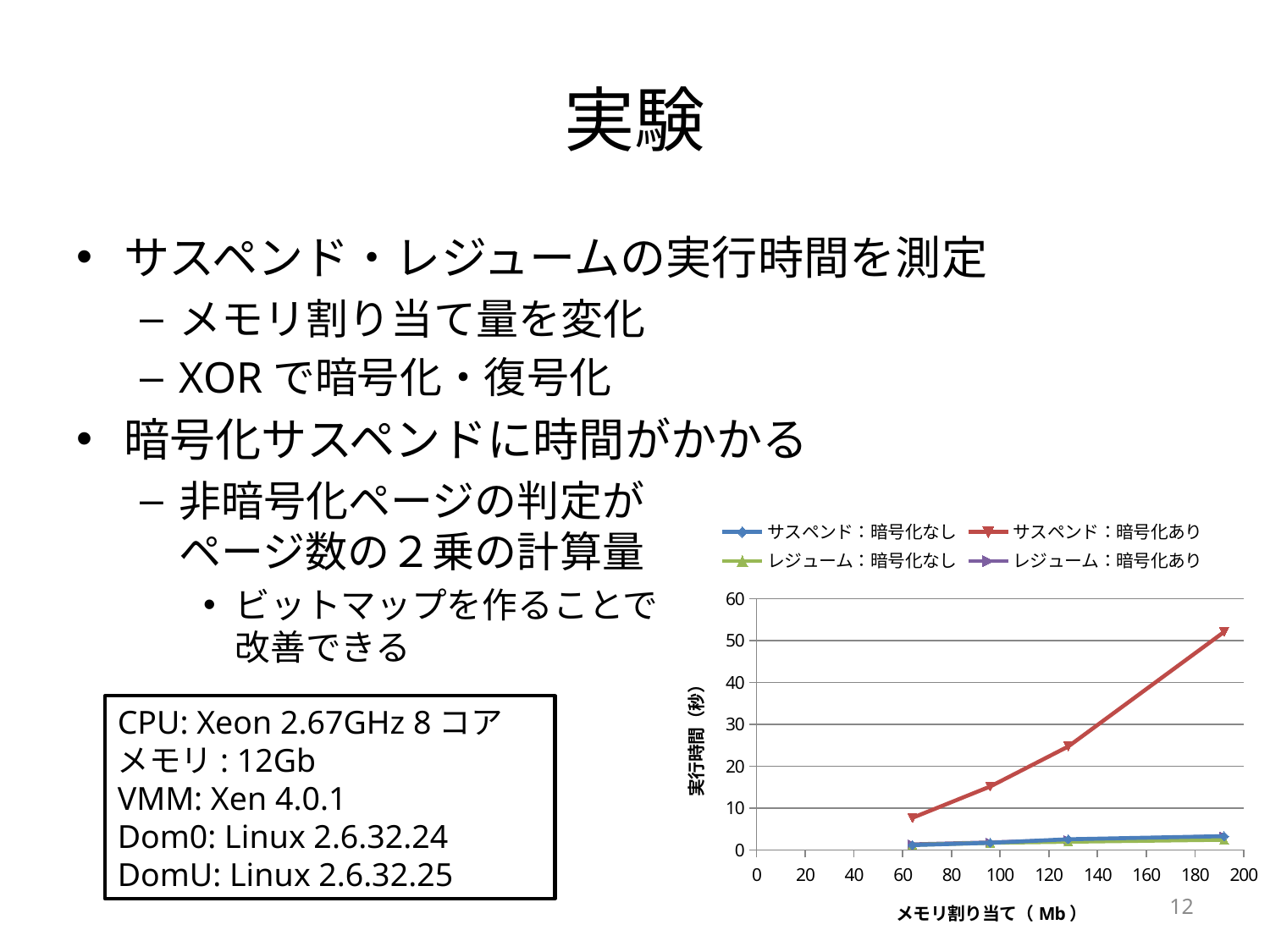
Does the execution time for サスペンド：暗号化あり rise or fall as memory allocation increases? rise Is the value for サスペンド：暗号化あり at 128 Mb greater or less than 20? greater Is the value for サスペンド：暗号化あり at 64 Mb greater or less than 10? less What is the title of the chart's y axis? 実行時間（秒） What kind of chart is shown on the slide? line chart How many data points are plotted for the サスペンド：暗号化あり series? 4 Which series has the highest execution time at 192 Mb of memory allocation? サスペンド：暗号化あり Is the value for サスペンド：暗号化あり at 192 Mb greater or less than 50? greater How many series does the chart legend list? 4 What is the title of the chart's x axis? メモリ割り当て（Mb） Which is larger at 128 Mb: サスペンド：暗号化あり or レジューム：暗号化なし? サスペンド：暗号化あり